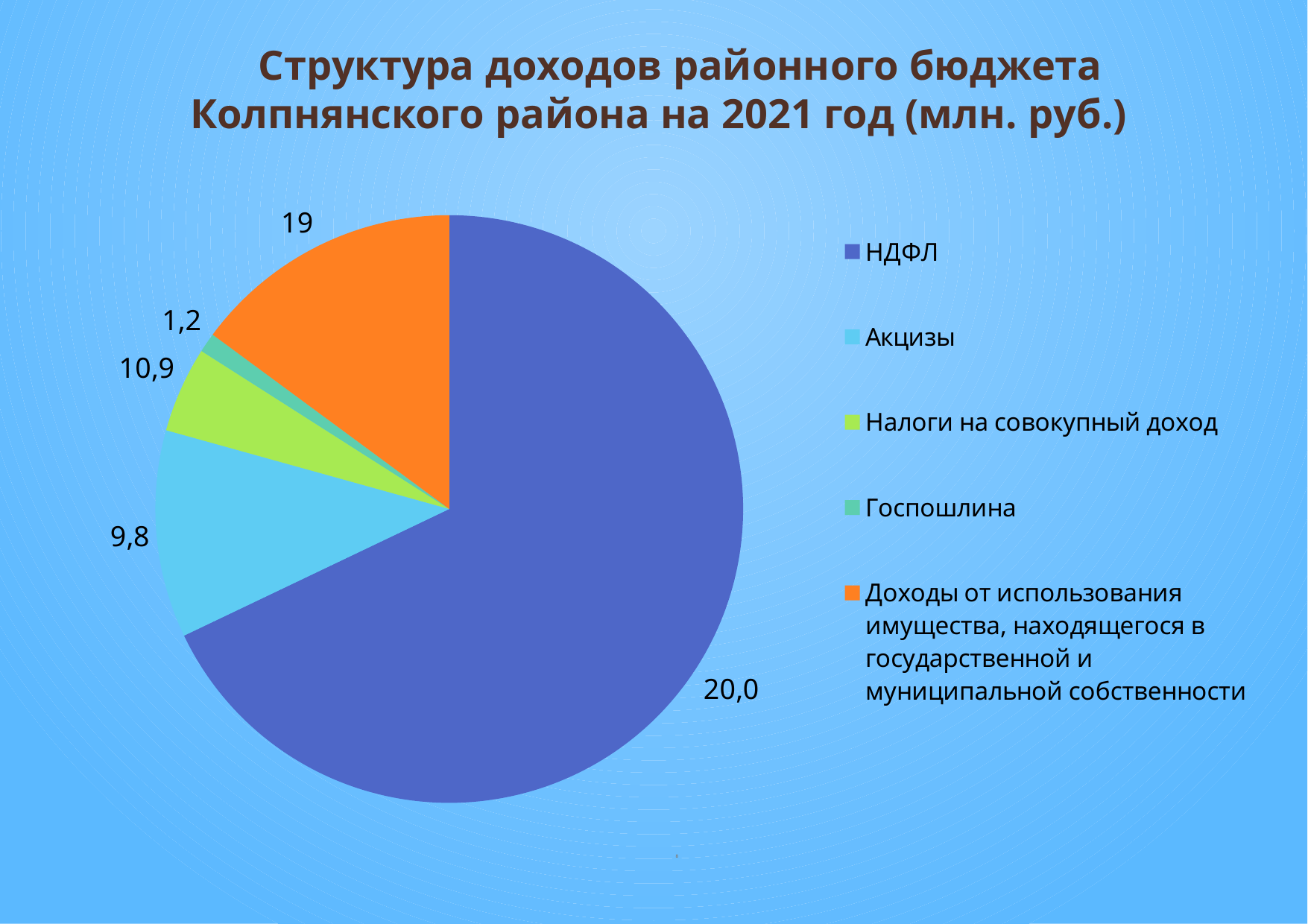
Which category has the largest slice of the pie? НДФЛ What kind of chart is shown on the slide? pie chart What is the value shown for Налоги на совокупный доход? 10,9 Which is larger, the slice for НДФЛ or the slice for Госпошлина? НДФЛ Which category has the smallest slice of the pie? Госпошлина What is the difference between the value for НДФЛ and the value for Госпошлина? 18,8 How many categories does the pie chart have? 5 What is the value shown for Госпошлина? 1,2 What is the value shown for НДФЛ? 20,0 What is the value shown for Доходы от использования имущества, находящегося в государственной и муниципальной собственности? 19 What is the value shown for Акцизы? 9,8 What is the title of the chart? Структура доходов районного бюджета Колпнянского района на 2021 год (млн. руб.)